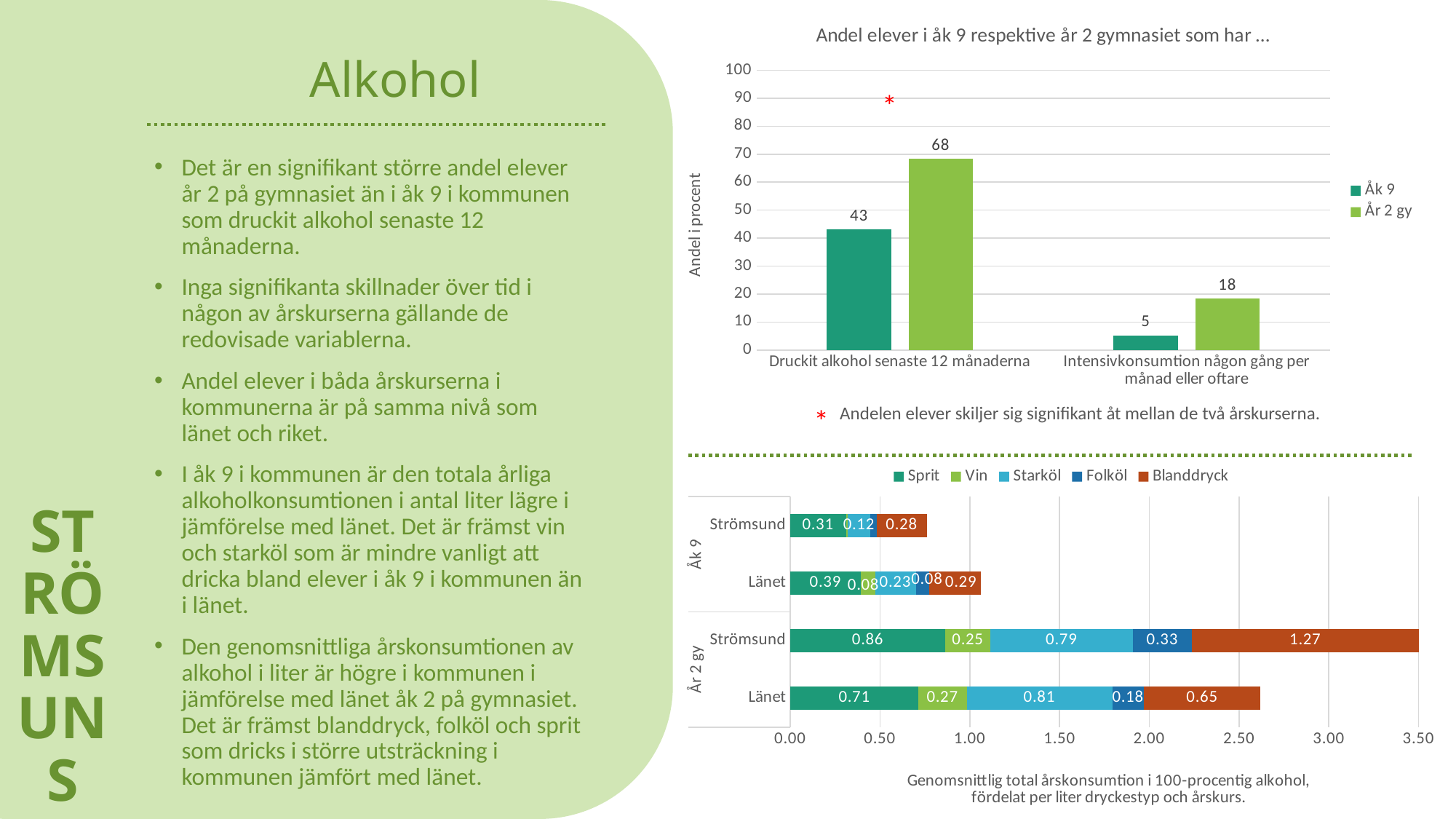
In the bottom chart, what is the Starköl value for Länet in År 2 gy? 0.81 In the top chart, which series has the higher value for 'Intensivkonsumtion någon gång per månad eller oftare'? År 2 gy In the top chart, what is the value for Åk 9 for 'Druckit alkohol senaste 12 månaderna'? 43 In the bottom chart, what is the Blanddryck value for Strömsund in År 2 gy? 1.27 In the bottom chart, which segment is the largest in the Strömsund År 2 gy bar? Blanddryck What kind of chart is the top chart? Bar chart In the top chart, what is the value for År 2 gy for 'Intensivkonsumtion någon gång per månad eller oftare'? 18 In the top chart, what is the difference between År 2 gy and Åk 9 for 'Druckit alkohol senaste 12 månaderna'? 25 In the top chart, how many series does the legend list? 2 In the bottom chart, what is the total of the stacked bar for Länet in Åk 9? 1.07 In the bottom chart, how many series does the legend list? 5 In the bottom chart, what is the total of the stacked bar for Strömsund in År 2 gy? 3.50